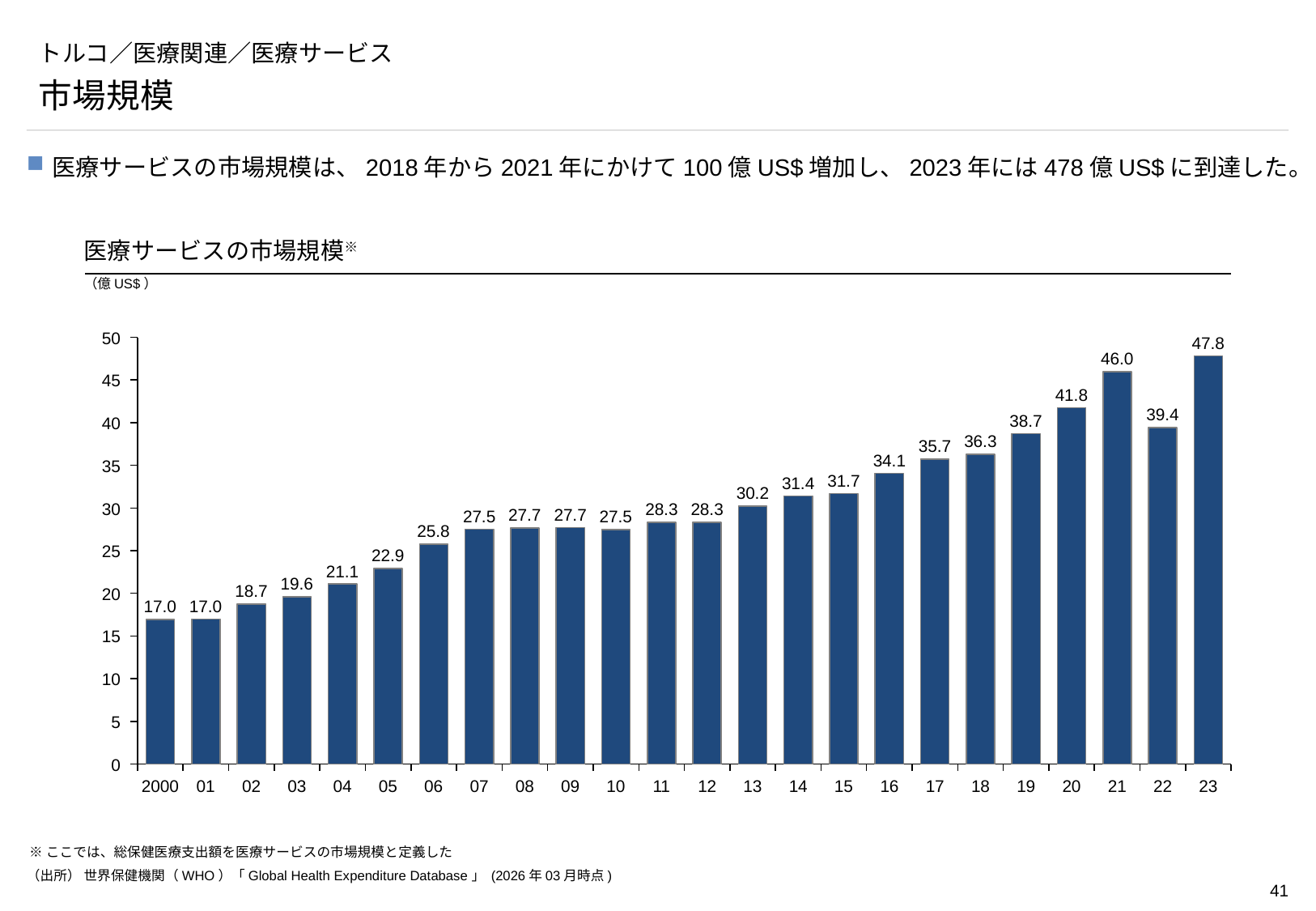
Which is larger, the value for 2020 or the value for 2022? 2020 How many years are shown on the x axis of the chart? 24 What is the value for 2010 in the chart? 27.5 What is the value for 2023 in the chart? 47.8 Which year has the lowest value in the chart? 2000 and 01 (both 17.0) What kind of chart is shown on the slide? bar chart What is the difference between the values for 2021 and 2022? 6.6 Is the value for 2013 greater or less than 30? greater Do the values generally rise or fall from 2000 to 2023? rise What unit is shown for the chart's values? 億 US$ What is the value for 2018 in the chart? 36.3 Which year has the highest value in the chart? 23